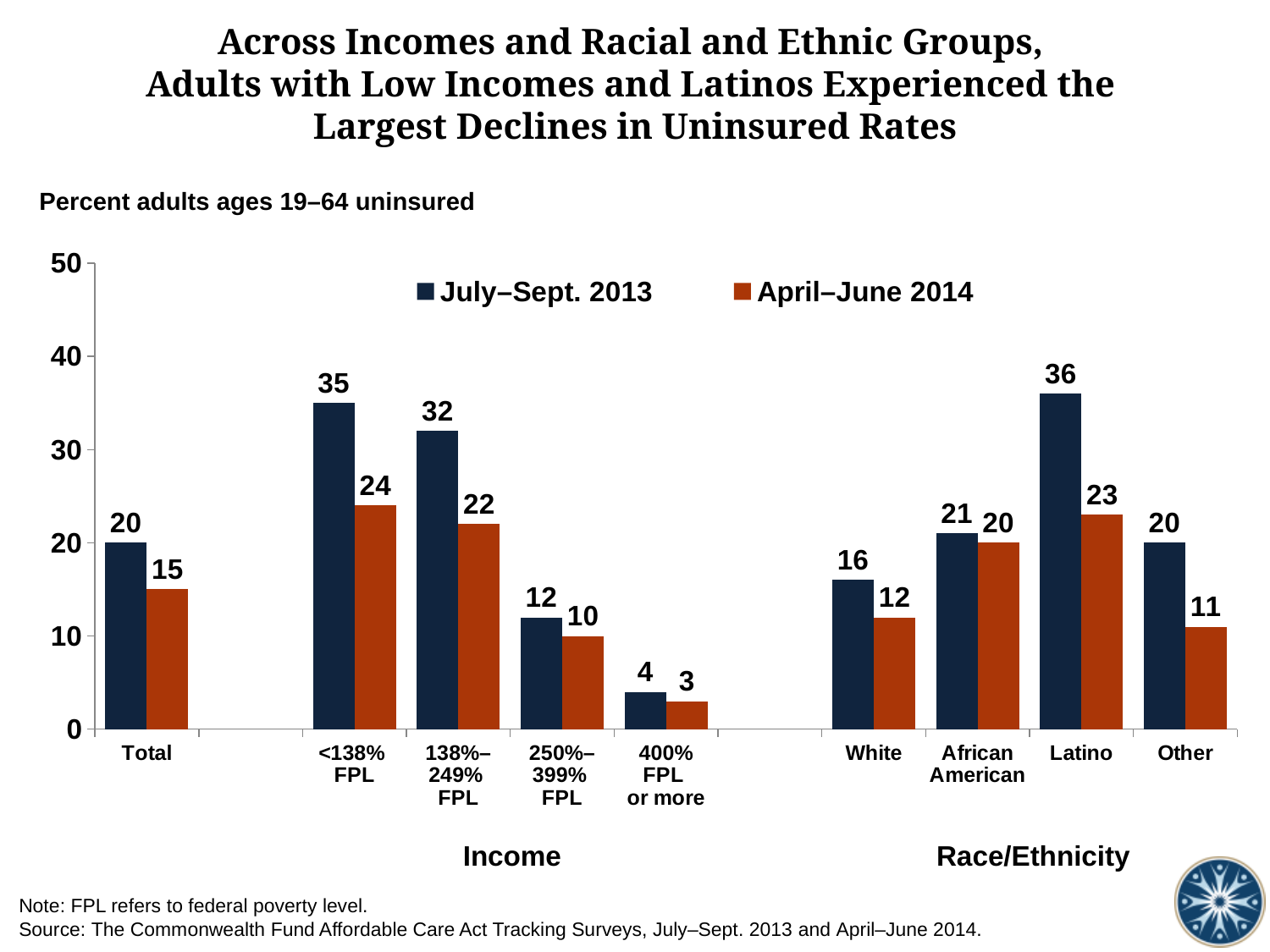
What is the difference between the July–Sept. 2013 and April–June 2014 uninsured rates for Latino adults? 13 Which series is shown in dark navy blue? July–Sept. 2013 What was the uninsured rate for adults with incomes of 400% FPL or more in April–June 2014? 3 Which was higher in April–June 2014: the uninsured rate for White adults or for African American adults? African American Which category had the lowest uninsured rate in April–June 2014? 400% FPL or more What was the Total uninsured rate in April–June 2014? 15 How many series does the legend list? 2 What kind of chart is shown on the slide? Bar chart What was the uninsured rate for Latino adults in July–Sept. 2013? 36 By how many percentage points did the uninsured rate for adults under 138% FPL fall from July–Sept. 2013 to April–June 2014? 11 How many categories are shown on the x axis? 9 Which category had the highest uninsured rate in July–Sept. 2013? Latino